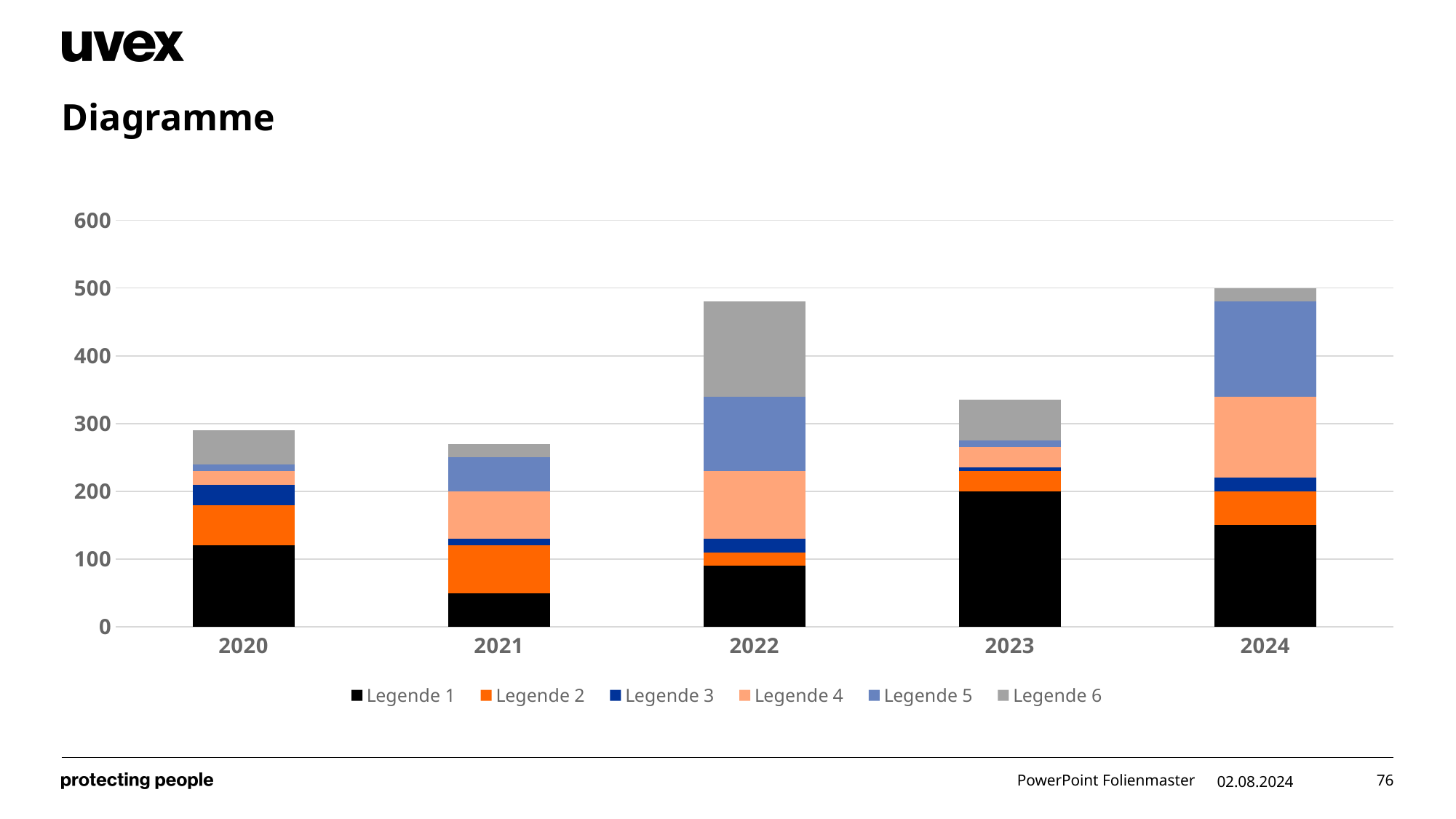
Is the total of the stacked bar for 2022 greater or less than 400? greater Which stacked bar is taller, 2022 or 2023? 2022 Which year has the larger Legende 5 segment, 2024 or 2023? 2024 What kind of chart is shown on the slide? Stacked bar chart Which year has the smallest Legende 1 (black) segment? 2021 How many years are shown on the x axis of the chart? 5 How many series does the chart legend list? 6 Is the total of the stacked bar for 2021 greater or less than 300? less Which year has the largest Legende 1 (black) segment? 2023 Which year has the tallest stacked bar overall? 2024 Is the total of the stacked bar for 2023 greater or less than 300? greater What is the title of the slide containing the chart? Diagramme